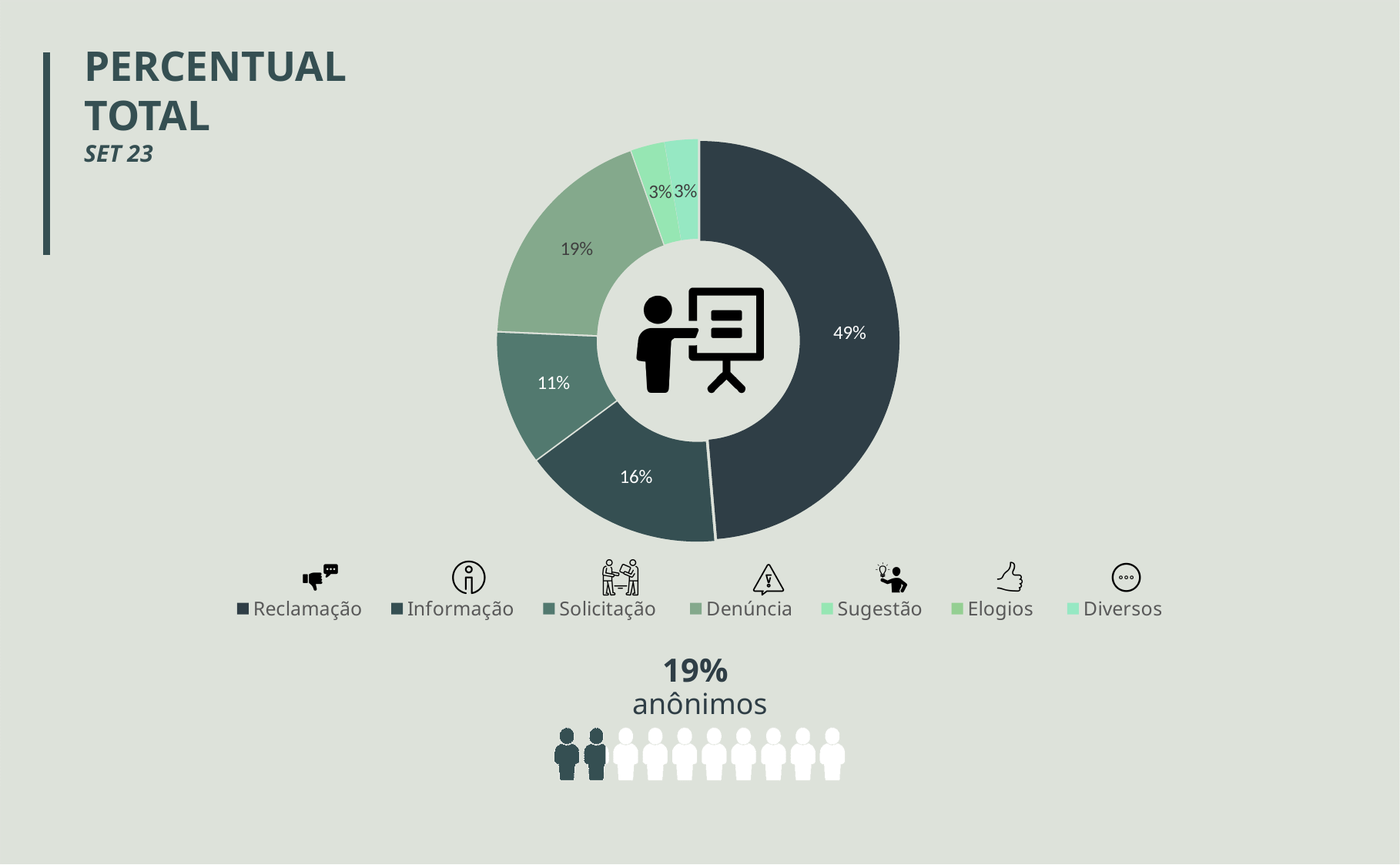
What is the title of the slide containing the chart? PERCENTUAL TOTAL What percentage of the pie chart does Reclamação represent? 49% What period is indicated under the chart title? SET 23 What is the value shown for Denúncia in the pie chart? 19% What kind of chart is shown on the slide? Doughnut chart How many categories does the chart legend list? 7 Is the value for Reclamação greater or less than 50%? less What is the difference in percentage points between Reclamação and Denúncia? 30 Which category has the largest slice in the pie chart? Reclamação Which is larger in the pie chart, Informação or Solicitação? Informação What is the value shown for Informação in the pie chart? 16% What is the value shown for Solicitação in the pie chart? 11%